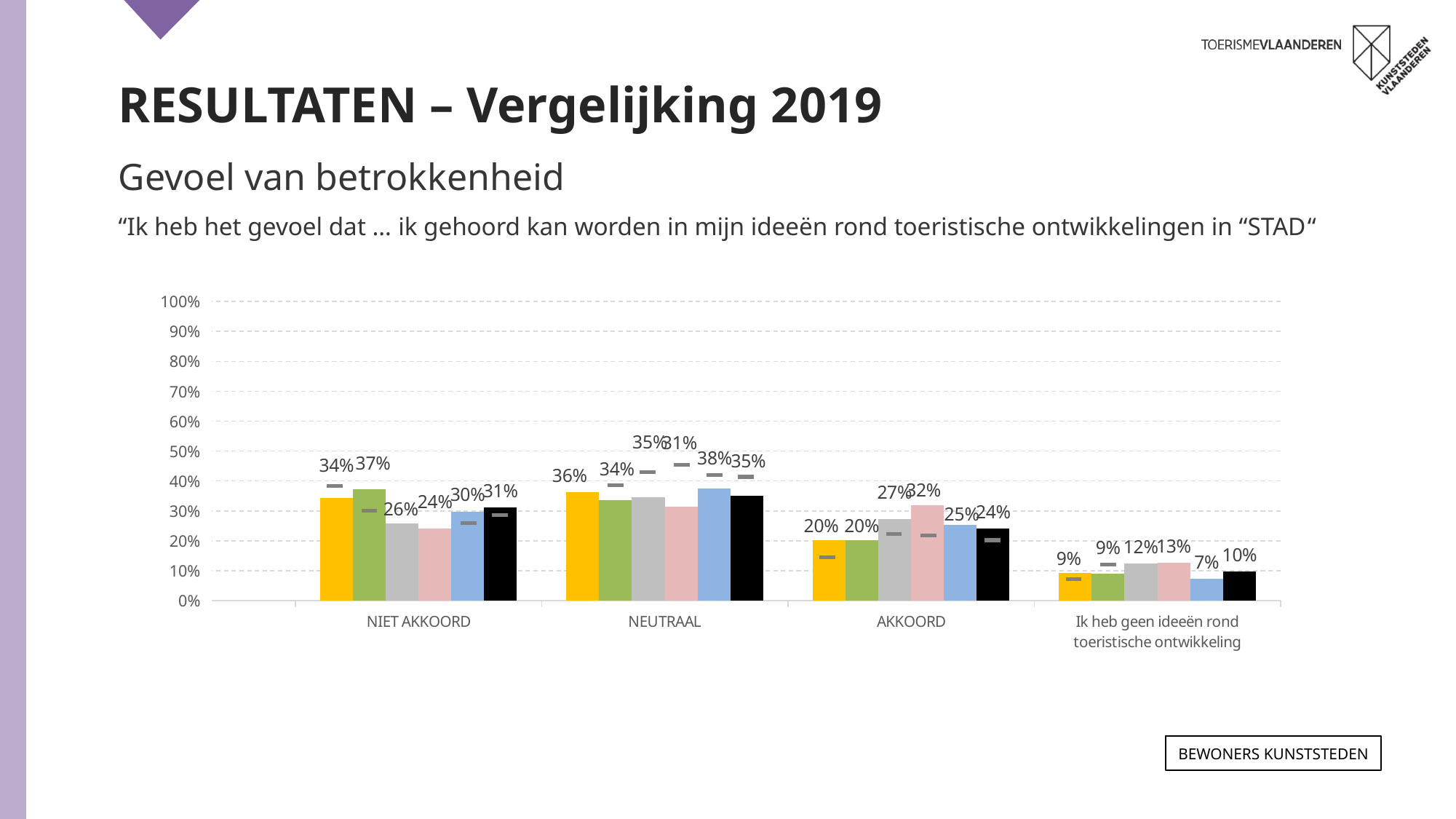
What kind of chart is shown on the slide? bar chart How many bars are plotted for each category in the chart? 6 What is the difference between the green bar (37%) and the pink bar (24%) in the NIET AKKOORD category? 13 percentage points How many categories are shown on the x axis of the chart? 4 Which category has the lowest values overall in the chart? Ik heb geen ideeën rond toeristische ontwikkeling What is the value of the blue bar for 'Ik heb geen ideeën rond toeristische ontwikkeling'? 7% Which bar is the highest in the NEUTRAAL category? the blue bar (38%) What is the value of the pink bar for AKKOORD? 32% Is the yellow bar for AKKOORD larger or smaller than the yellow bar for NIET AKKOORD? smaller Is the value of the blue bar for NEUTRAAL greater or less than 30%? greater What is the value of the yellow bar for NEUTRAAL? 36% What is the value of the black bar for NIET AKKOORD? 31%